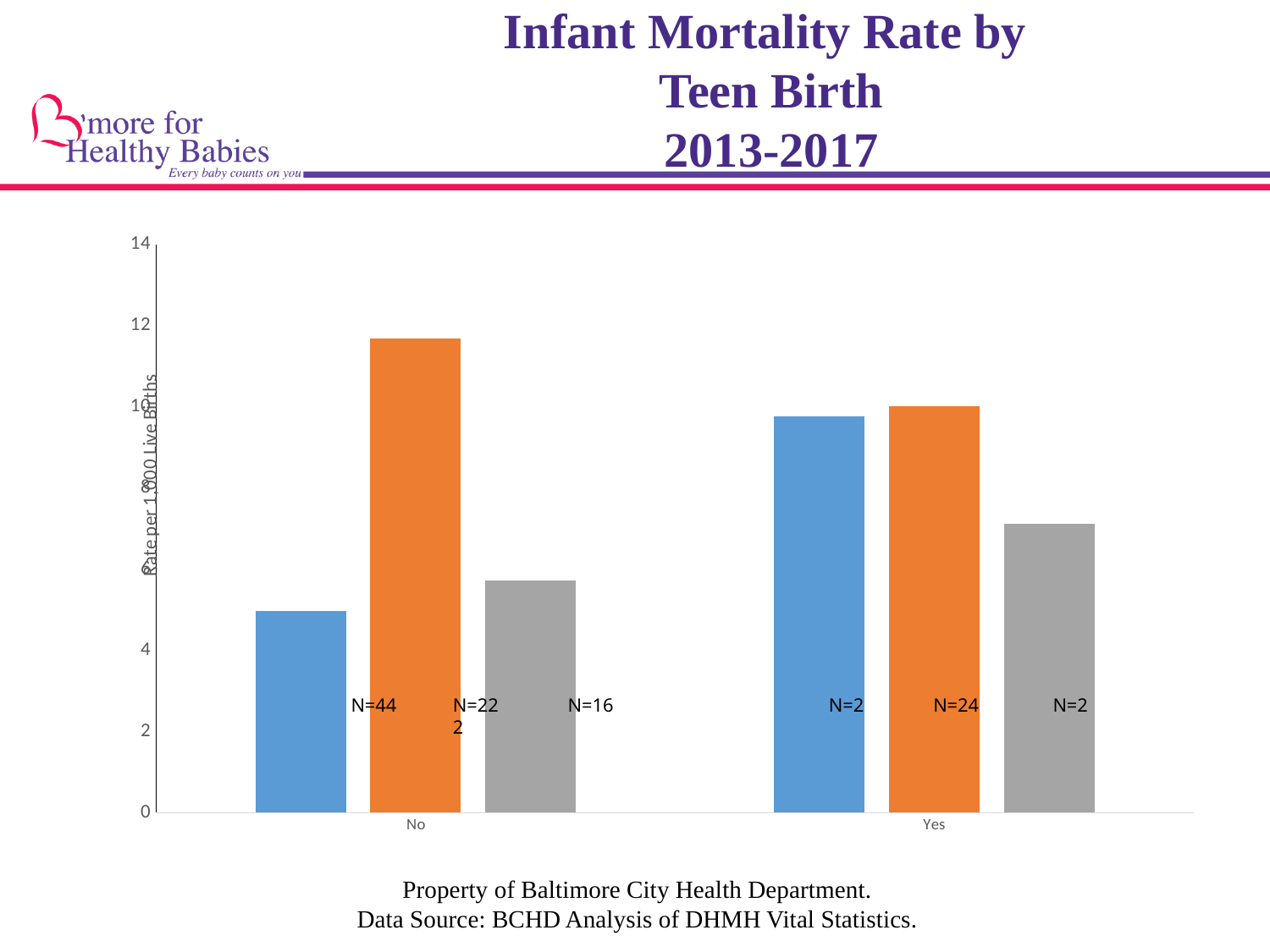
Is the value of the gray bar in the Yes category greater or less than 6? greater Which category contains the tallest bar in the chart? No Which bar is the shortest in the chart? the blue bar in the No category Which is larger, the orange bar in the No category or the orange bar in the Yes category? No Is the value of the orange bar in the No category greater or less than 10? greater Is the value of the blue bar in the Yes category greater or less than 8? greater What is the title of the chart? Infant Mortality Rate by Teen Birth 2013-2017 Which is larger, the blue bar in the No category or the blue bar in the Yes category? Yes How many categories are shown on the x axis? 2 What is the label on the vertical axis? Rate per 1,000 Live Births What kind of chart is shown on the slide? bar chart